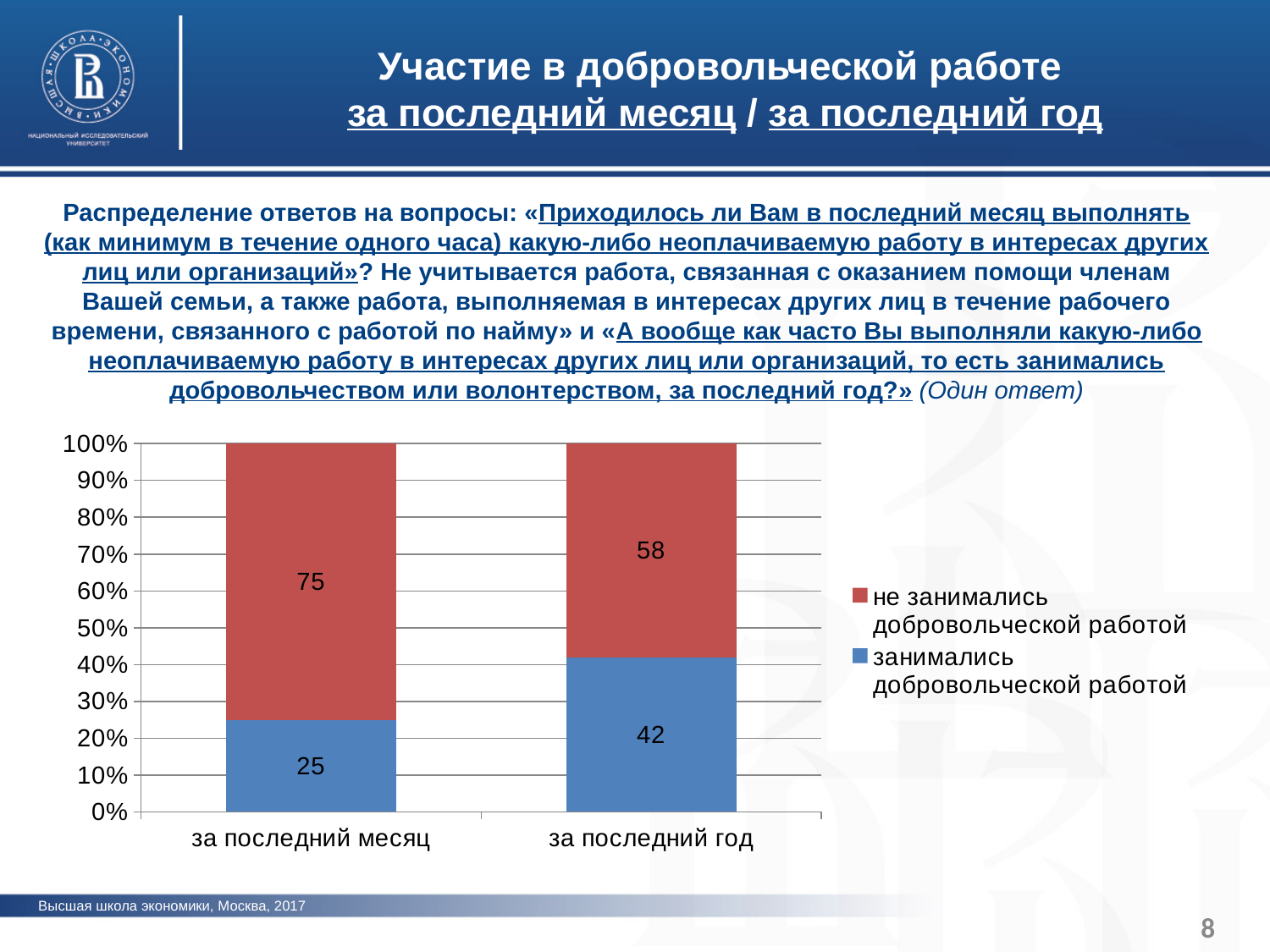
How many series does the legend list? 2 What value is shown for "занимались добровольческой работой" in the "за последний месяц" bar? 25 How many categories are shown on the x axis? 2 What value is shown for "занимались добровольческой работой" in the "за последний год" bar? 42 What value is shown for "не занимались добровольческой работой" in the "за последний месяц" bar? 75 Is the "не занимались добровольческой работой" value larger for "за последний месяц" or "за последний год"? за последний месяц Which category has the higher value for "занимались добровольческой работой"? за последний год Which category has the lower value for "не занимались добровольческой работой"? за последний год What is the difference between the "занимались добровольческой работой" values for "за последний год" and "за последний месяц"? 17 What value is shown for "не занимались добровольческой работой" in the "за последний год" bar? 58 Which colour represents "занимались добровольческой работой" in the chart? blue What kind of chart is shown on the slide? stacked bar chart